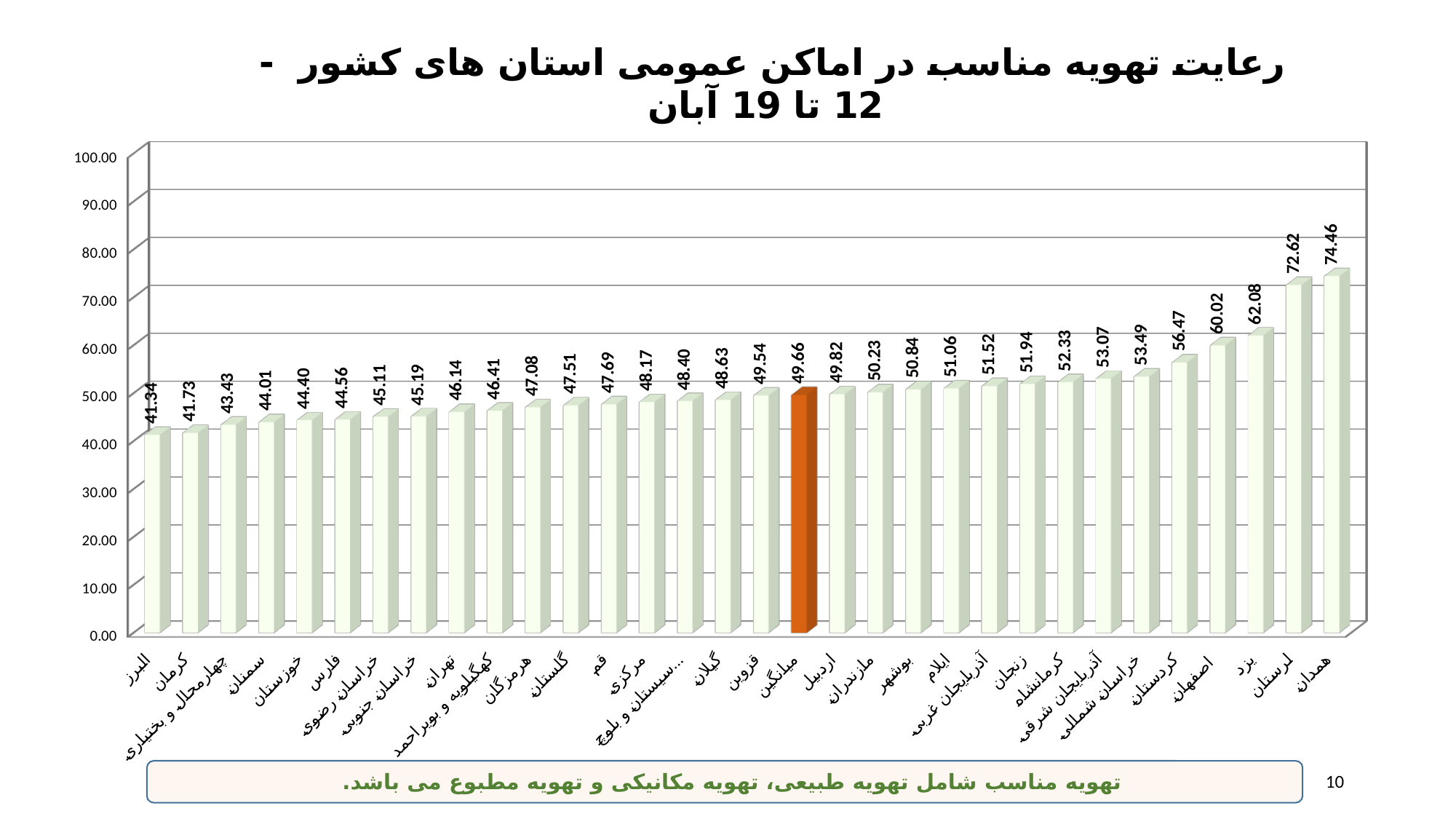
How many bars are plotted in the chart? 32 What is the value for تهران? 46.14 Which category has the lowest value? البرز What is the difference between the values for همدان and البرز? 33.12 Which bar is coloured orange instead of light green? میانگین What is the value for همدان? 74.46 Which is larger, the value for یزد or the value for اصفهان? یزد Is the value for کردستان greater or less than 50.00? greater Do the values rise or fall from left to right along the x axis? rise What is the value of the orange bar labelled میانگین? 49.66 What kind of chart is shown on the slide? bar chart Which category has the highest value? همدان